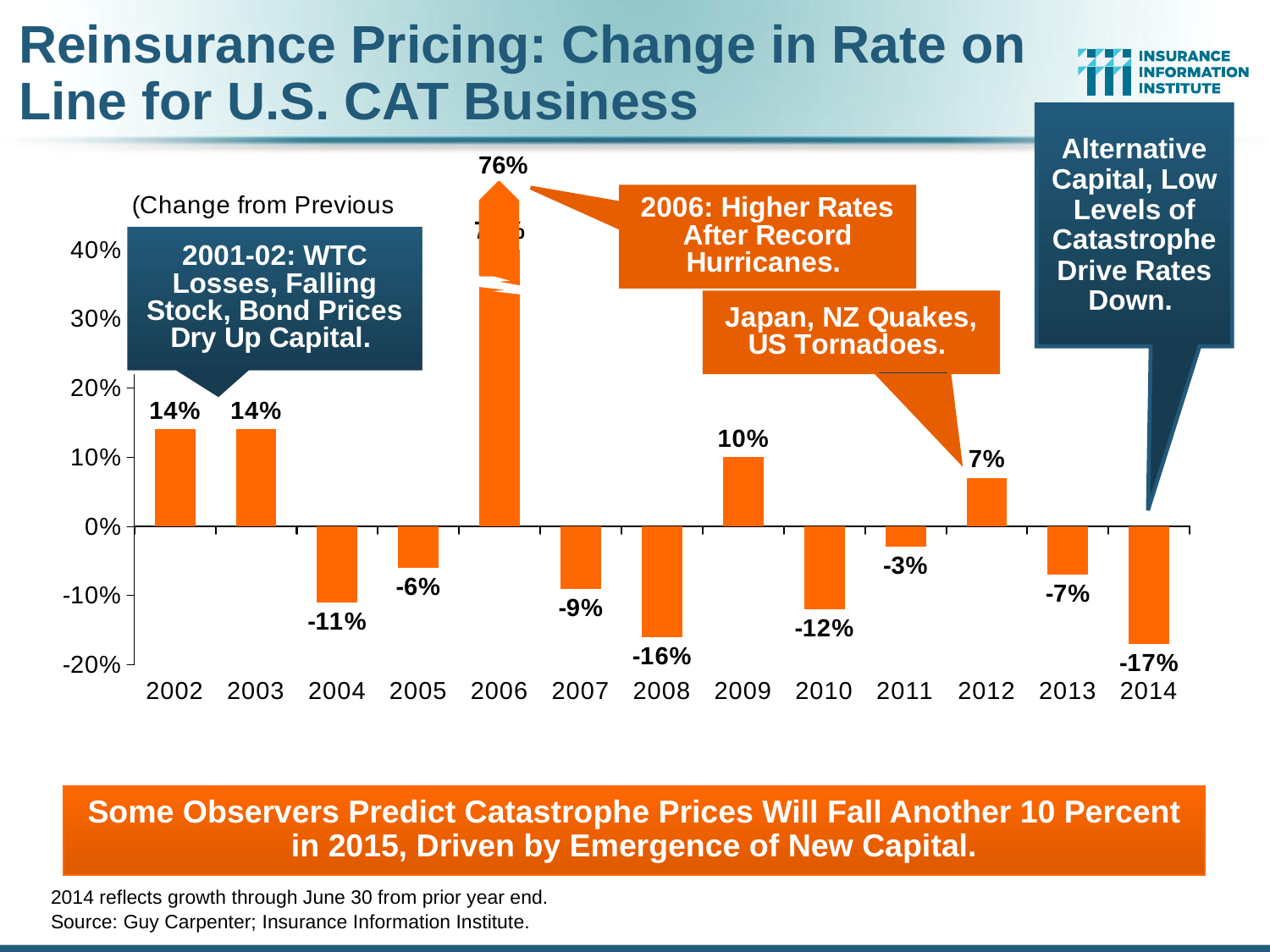
Which year has the highest change in rate on line? 2006 What is the difference between the 2008 value and the 2010 value? 4 percentage points Do the values fall or rise from 2012 to 2014? Fall Which year has the lowest change in rate on line? 2014 What is the change in rate on line for 2014? -17% According to the callout on the chart, what caused higher rates in 2006? Record hurricanes What is the change in rate on line for 2011? -3% What kind of chart is shown on the slide? Bar chart Which year has the larger change in rate on line, 2012 or 2009? 2009 What is the change in rate on line for 2006? 76% What is the change in rate on line for 2009? 10% How many years are shown on the x axis of the chart? 13